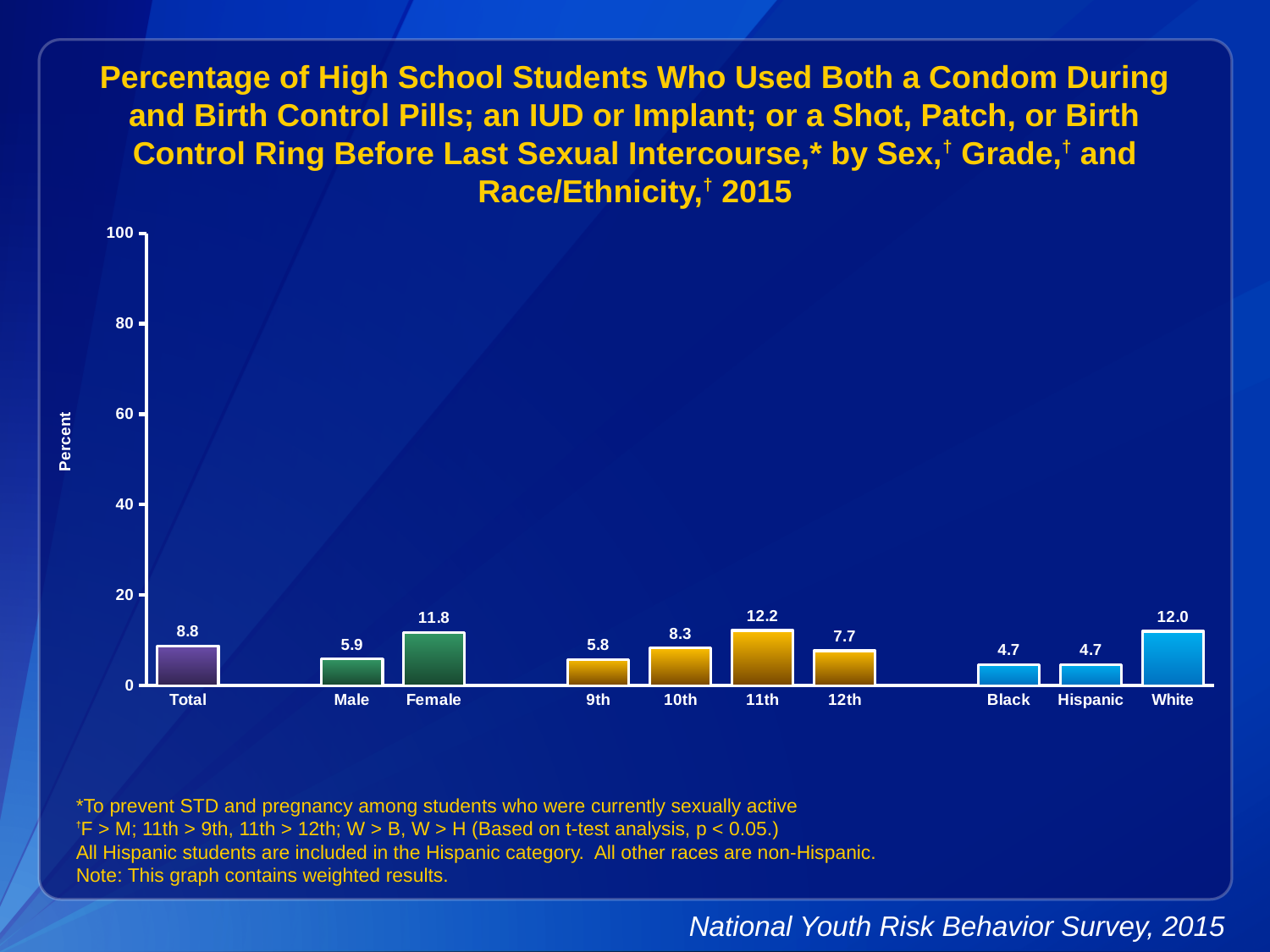
What is the difference between the Female and Male values? 5.9 What is the value for Total? 8.8 What is the difference between the White and Black values? 7.3 Is the value for White greater or less than 20? less What is the value for Female? 11.8 Which grade has the lowest value? 9th How many bars are shown in the chart? 10 What kind of chart is shown on the slide? bar chart What is the value for 11th grade? 12.2 Which is larger, the value for 10th grade or 12th grade? 10th What is the value for Hispanic students? 4.7 Which category has the highest value? 11th